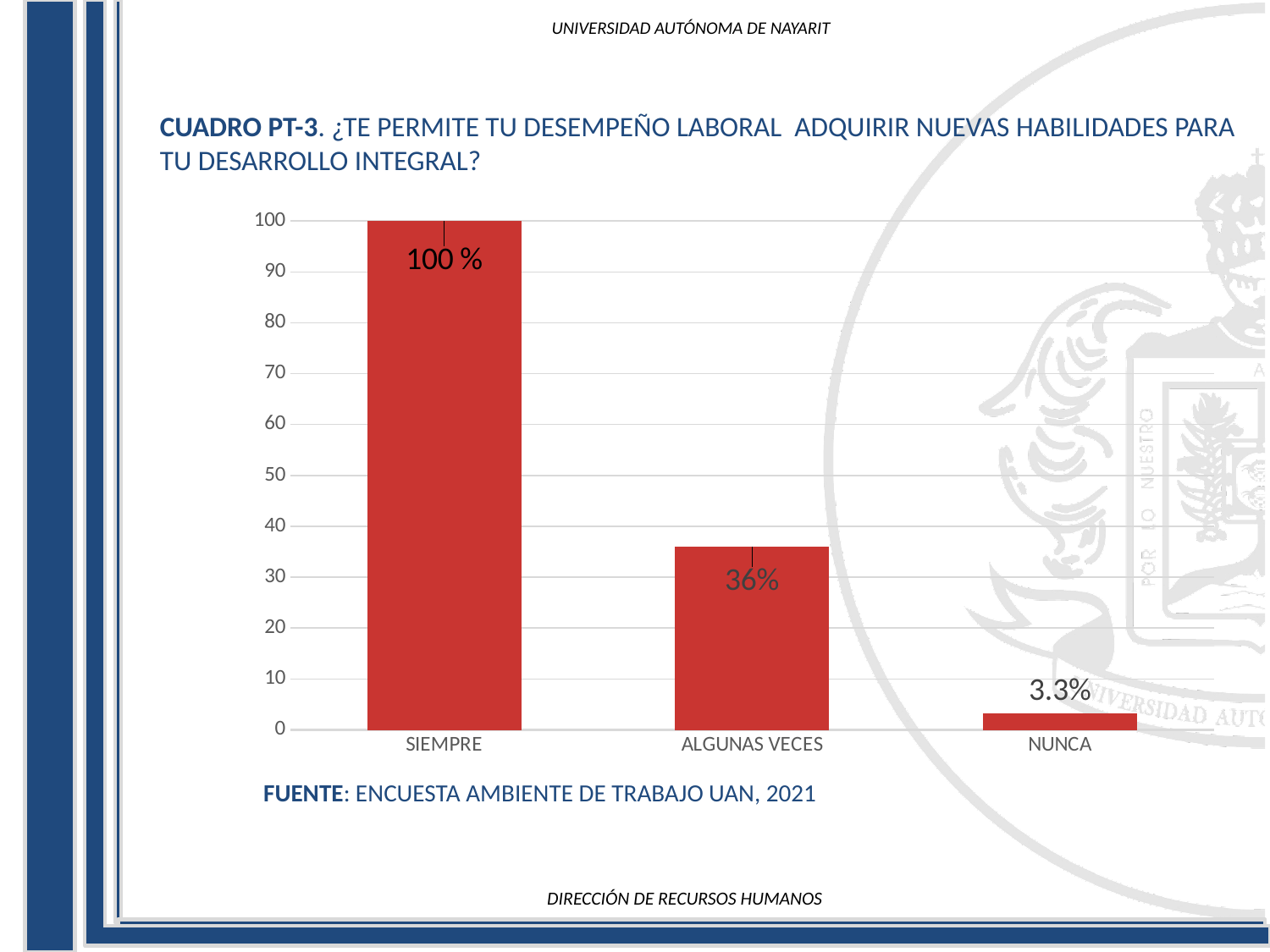
What is the difference between the values for SIEMPRE and ALGUNAS VECES? 64% What is the difference between the values for ALGUNAS VECES and NUNCA? 32.7% What value is shown for ALGUNAS VECES? 36% What value is shown for NUNCA? 3.3% What source is cited below the chart? ENCUESTA AMBIENTE DE TRABAJO UAN, 2021 What value is shown for SIEMPRE? 100 % Which category has the lowest value? NUNCA What kind of chart is shown on the slide? bar chart Which category has the highest value? SIEMPRE Is the value for ALGUNAS VECES greater or less than 40? less Which is larger, the value for ALGUNAS VECES or the value for NUNCA? ALGUNAS VECES How many categories are shown on the x axis? 3